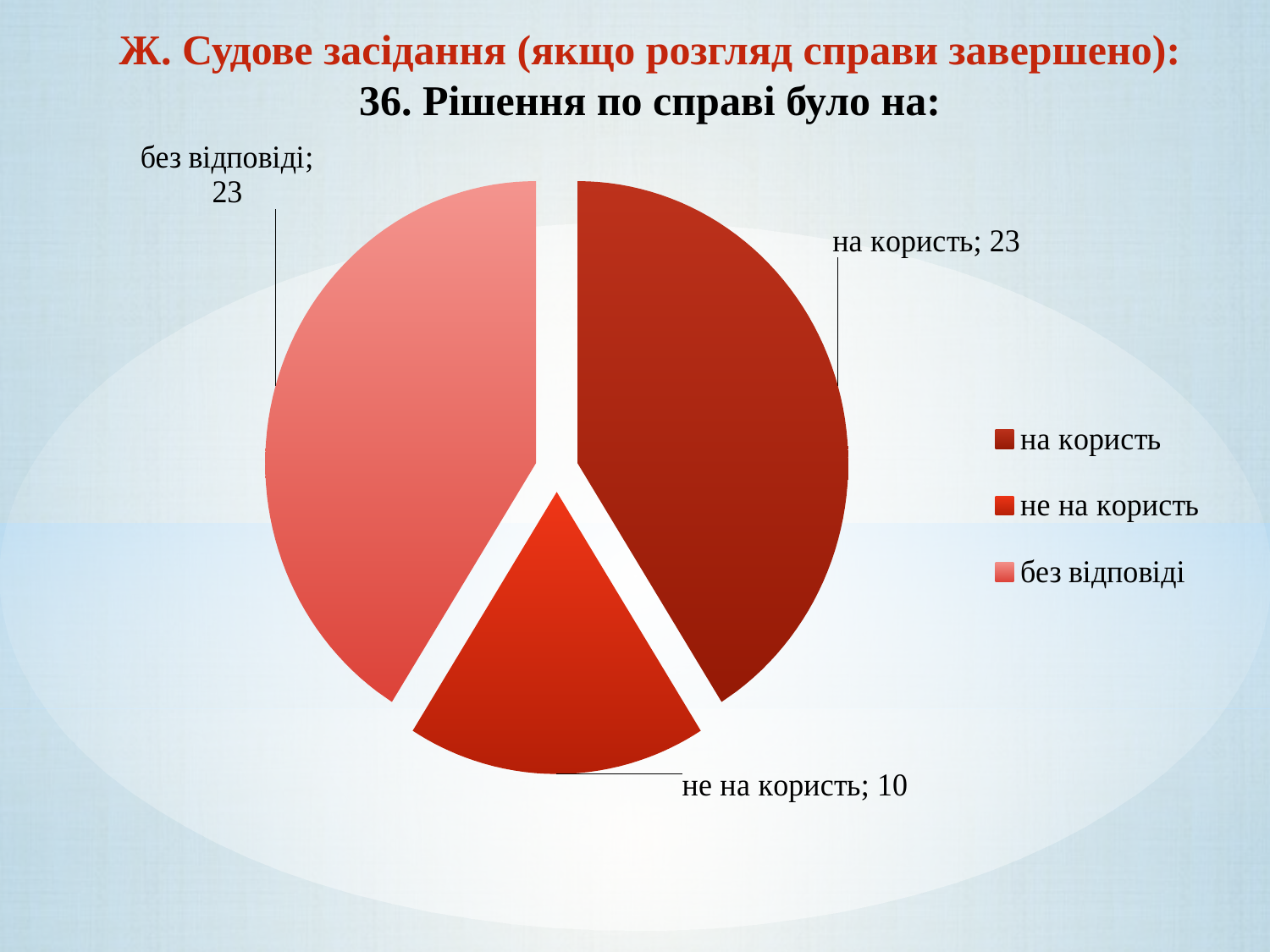
What is the total of all slices in the pie chart? 56 How many entries does the legend list? 3 Which category has the smallest slice? не на користь What is the title of the chart? 36. Рішення по справі було на: What is the value for "не на користь"? 10 What type of chart is shown on the slide? pie chart What is the value for "без відповіді"? 23 How many slices does the pie chart have? 3 What is the value for "на користь"? 23 What is the difference between the values for "на користь" and "не на користь"? 13 Which is larger, the value for "без відповіді" or the value for "не на користь"? без відповіді